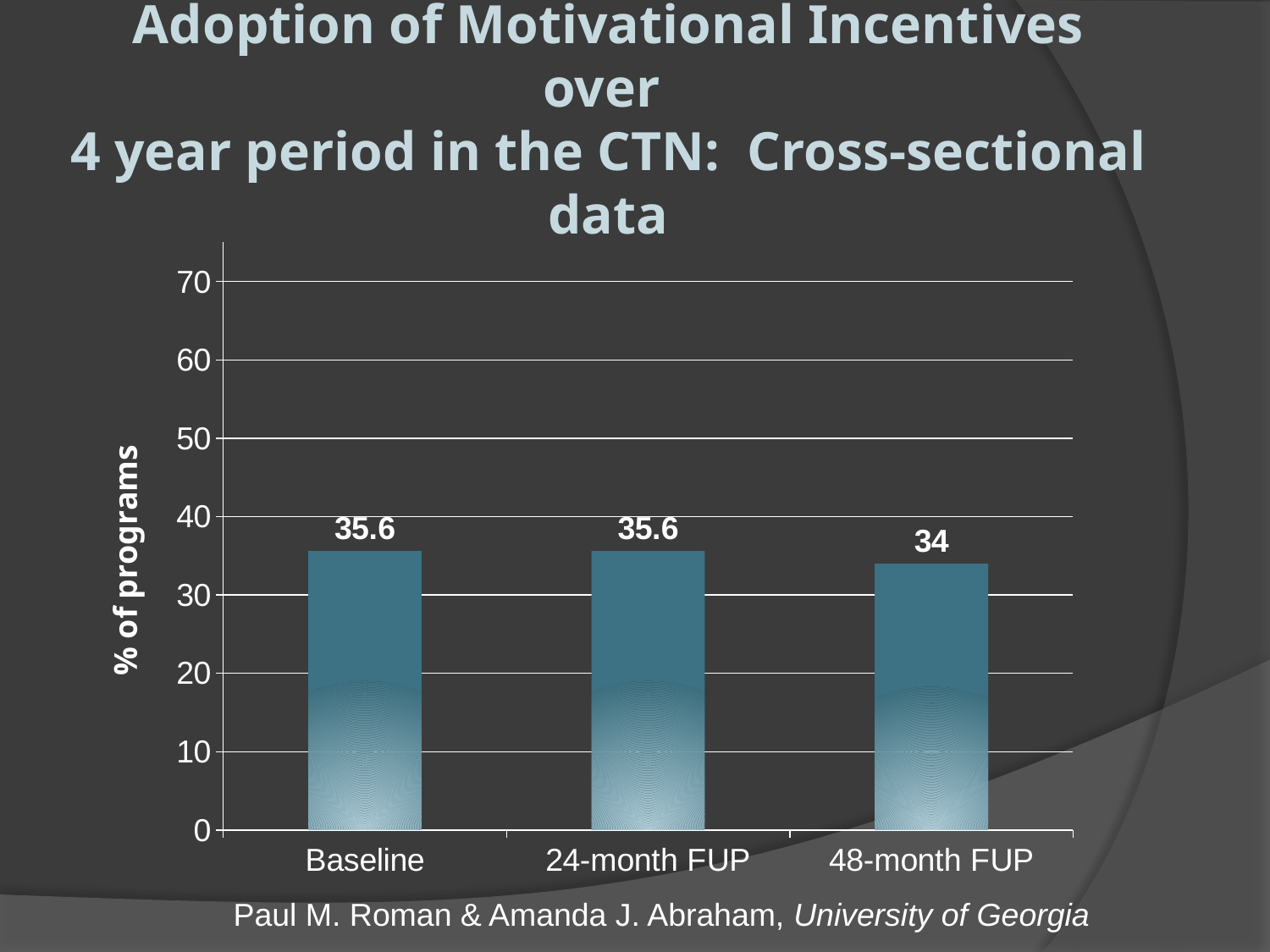
Is the value for Baseline greater or less than 40? less What is the value for 24-month FUP? 35.6 What kind of chart is shown on the slide? bar chart Is the value for 48-month FUP greater or less than 30? greater Do the values rise, fall, or stay the same from Baseline to 48-month FUP? fall Which is larger, the value for 24-month FUP or the value for 48-month FUP? 24-month FUP How many categories are shown on the x axis? 3 Which category has the lowest value? 48-month FUP What is the value for Baseline? 35.6 What is the difference between the Baseline value and the 48-month FUP value? 1.6 What is the label of the y axis? % of programs What is the value for 48-month FUP? 34